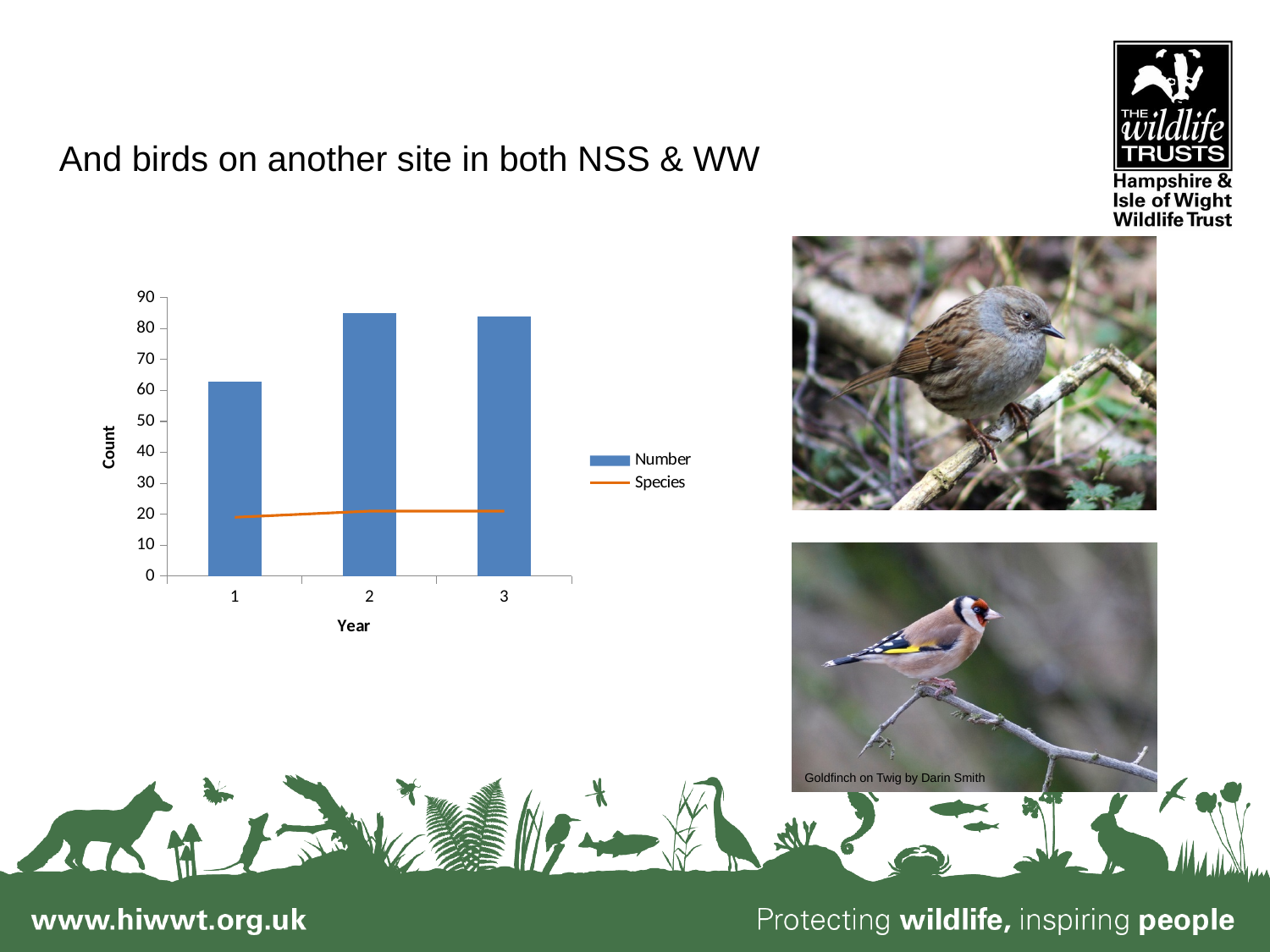
Does the Number value rise or fall from Year 1 to Year 2? rise Which year has the lowest Number value? 1 Is the Species value for Year 2 greater or less than 30? less How many years are shown on the x axis of the chart? 3 How many series does the chart legend list? 2 Is the Number value for Year 1 greater or less than 70? less What kind of chart is used to show the Number series? bar chart Is the Number value for Year 1 greater or less than 60? greater Which is larger, the Number value for Year 1 or for Year 2? Year 2 What is the title of the vertical axis of the chart? Count